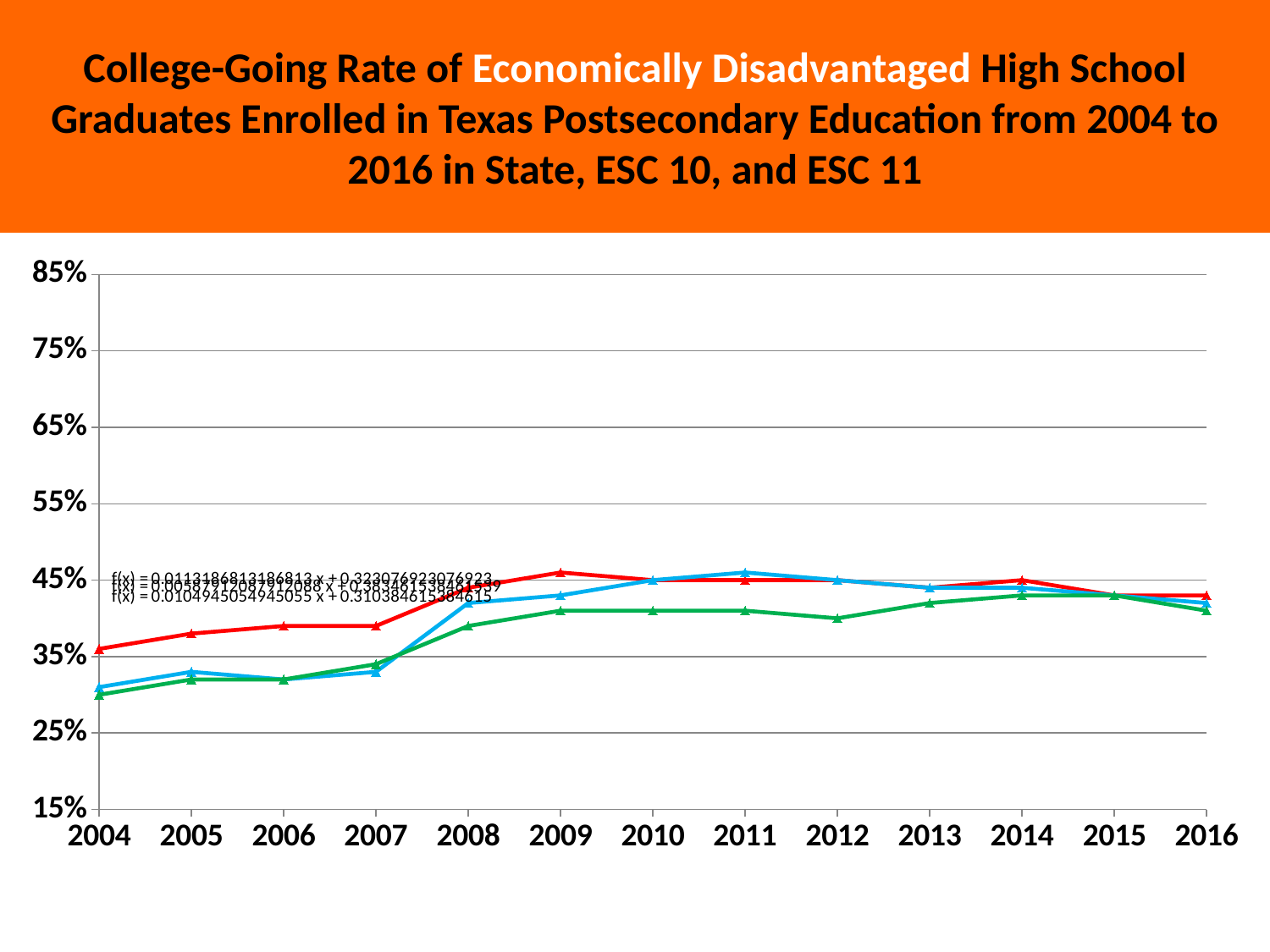
Is the value of the green line in 2012 greater or less than 45%? less In 2012, which line has the higher value, the blue line or the green line? blue line Is the value of the green line in 2004 greater or less than 35%? less Does the red line rise or fall from 2004 to 2009? rise How many lines are plotted on the chart? 3 How many years are plotted along the x axis of the chart? 13 Is the value of the red line in 2009 greater or less than 35%? greater What kind of chart is shown on the slide? line chart In which year is the green line at its lowest value? 2004 In 2004, which line has the higher value, the red line or the green line? red line